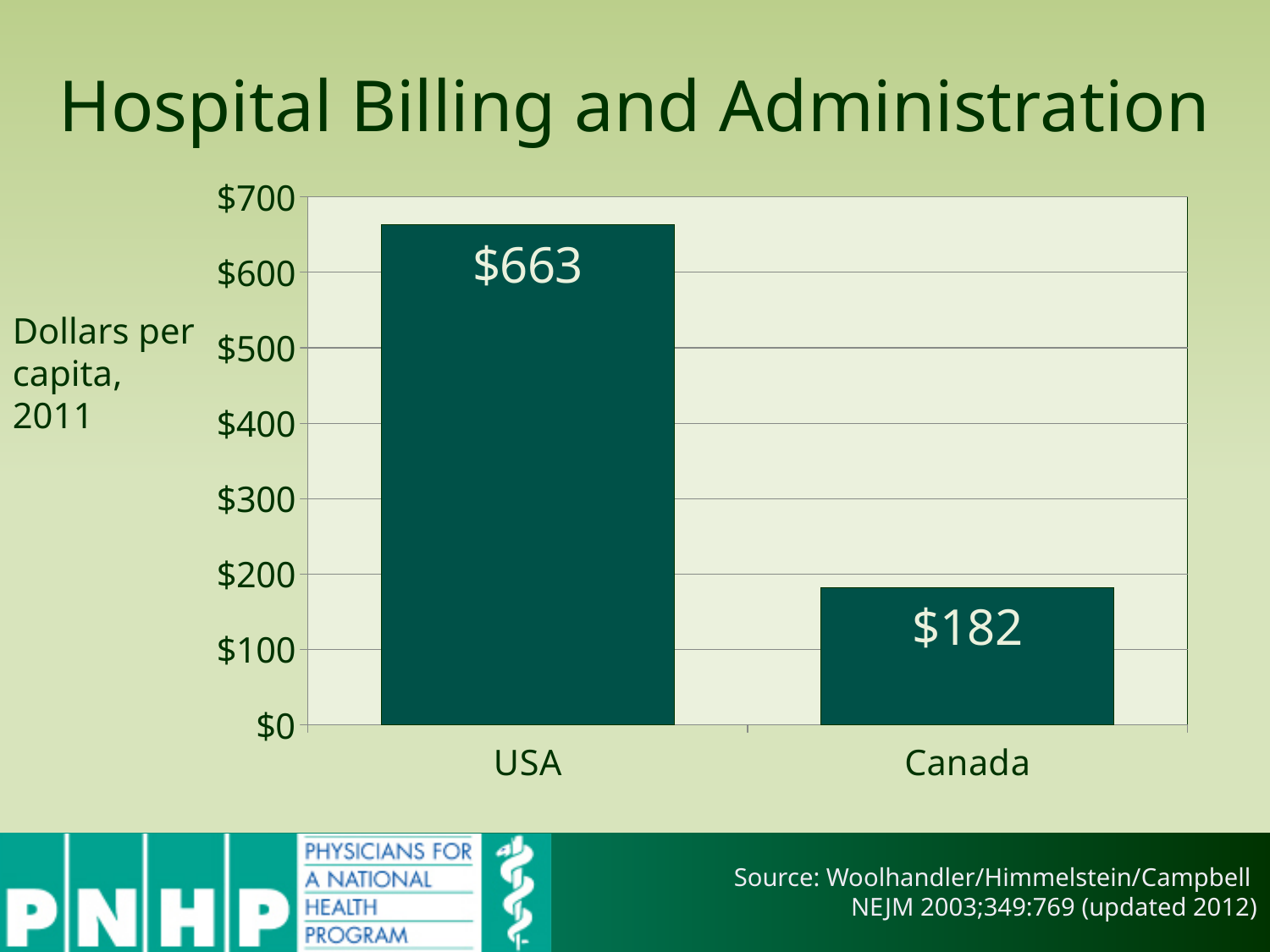
What kind of chart is shown on the slide? bar chart What is the difference between the USA and Canada values? $481 Which category has the lowest value? Canada Which category has the highest value? USA What is the title of the chart? Hospital Billing and Administration Is the value for USA greater or less than $600? greater Is the value for Canada greater or less than $200? less What is the value for USA? $663 Which is larger, the value for USA or the value for Canada? USA What is the value for Canada? $182 What unit does the y-axis label describe? Dollars per capita, 2011 How many categories are shown on the chart? 2